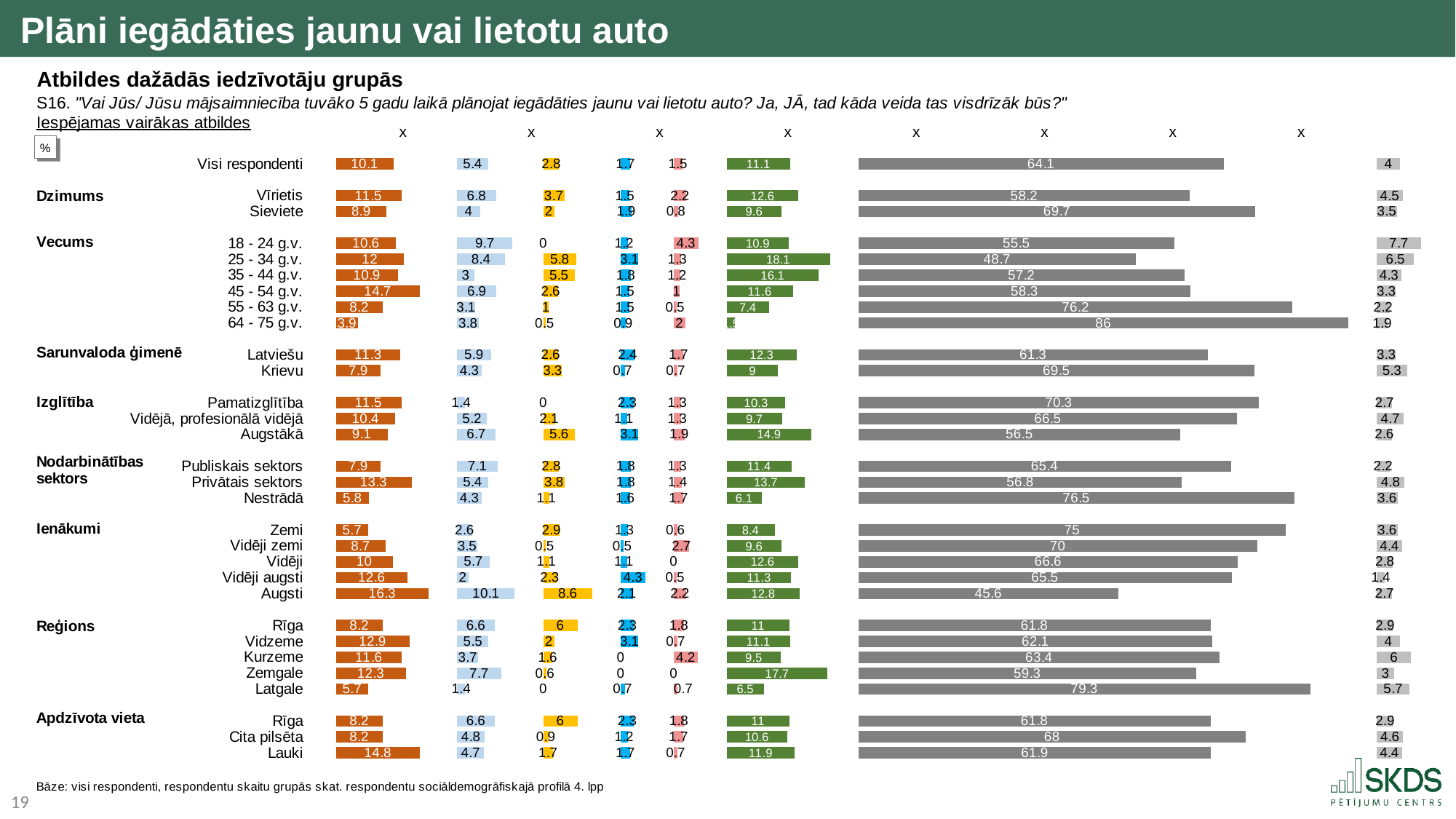
Which has the larger orange bar value, "Publiskais sektors" or "Privātais sektors"? Privātais sektors What kind of chart is shown on the slide? Bar chart What is the difference between the orange bar values for "Latviešu" and "Krievu"? 3.4 What value is shown on the orange bar for "Augsti" in the Ienākumi group? 16.3 Among the Reģions rows, which region has the highest value on the green bar? Zemgale What value is shown on the grey bar for the "64 - 75 g.v." age group? 86 Among the Ienākumi rows, which group has the lowest value on the grey bar? Augsti What value is shown on the orange bar for "Vīrietis"? 11.5 What is the difference between the grey bar values for "Sieviete" and "Vīrietis"? 11.5 What value is shown on the grey bar for "Visi respondenti"? 64.1 Among the Vecums (age) groups, which has the highest value on the grey bar? 64 - 75 g.v. How many regions are listed under Reģions? 5